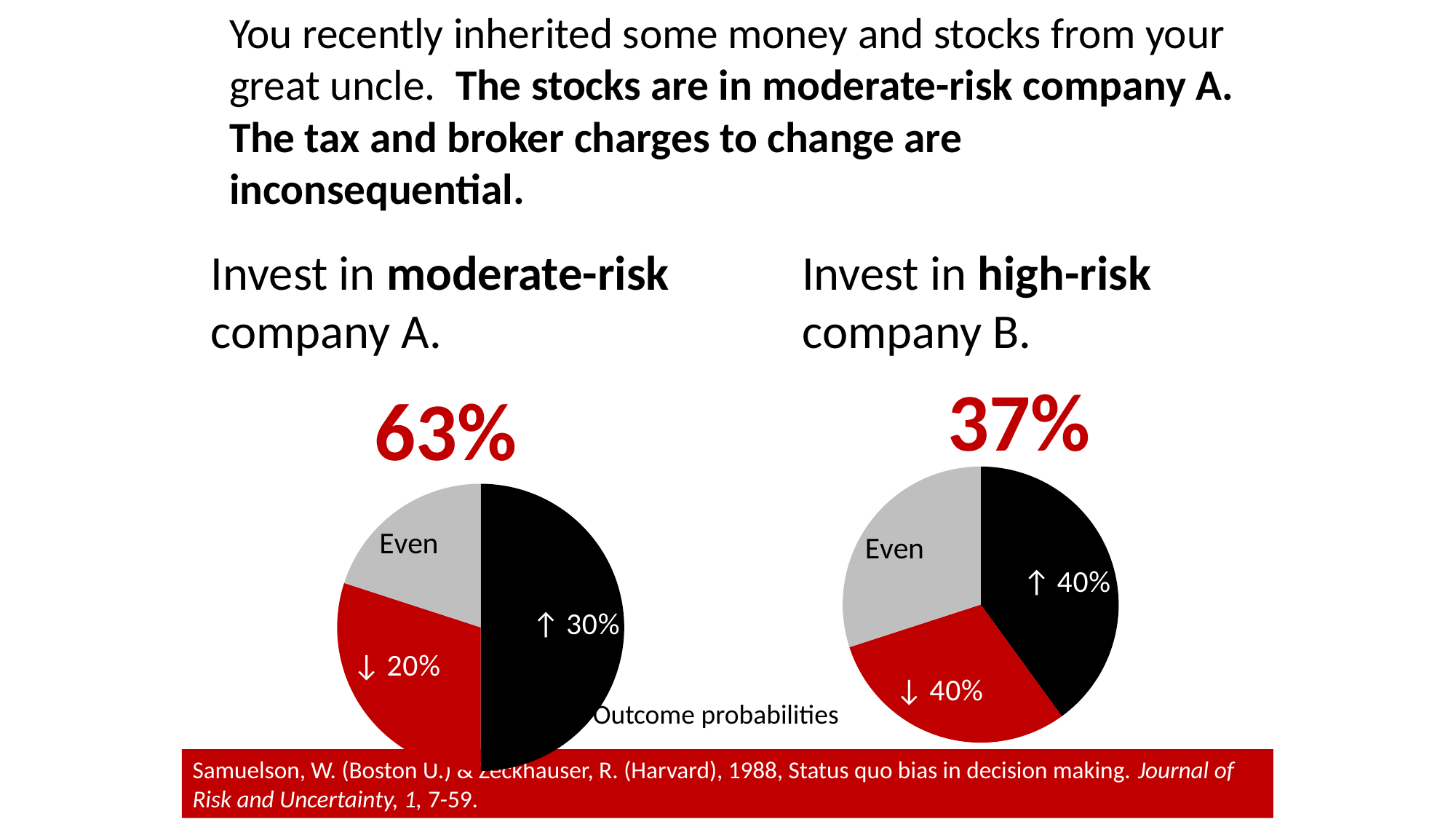
What kind of chart is used to show the outcome probabilities for company A and company B? Pie chart In the pie chart for high-risk company B, which is larger, the up (↑) probability or the down (↓) probability? Up (↑) What colour is the 'Even' slice in the pie chart for high-risk company B? Grey What label appears between the two pie charts describing what they show? Outcome probabilities In the pie chart for moderate-risk company A, which is larger, the up (↑) probability or the down (↓) probability? Up (↑) How many slices does the pie chart for moderate-risk company A have? 3 How many slices does the pie chart for high-risk company B have? 3